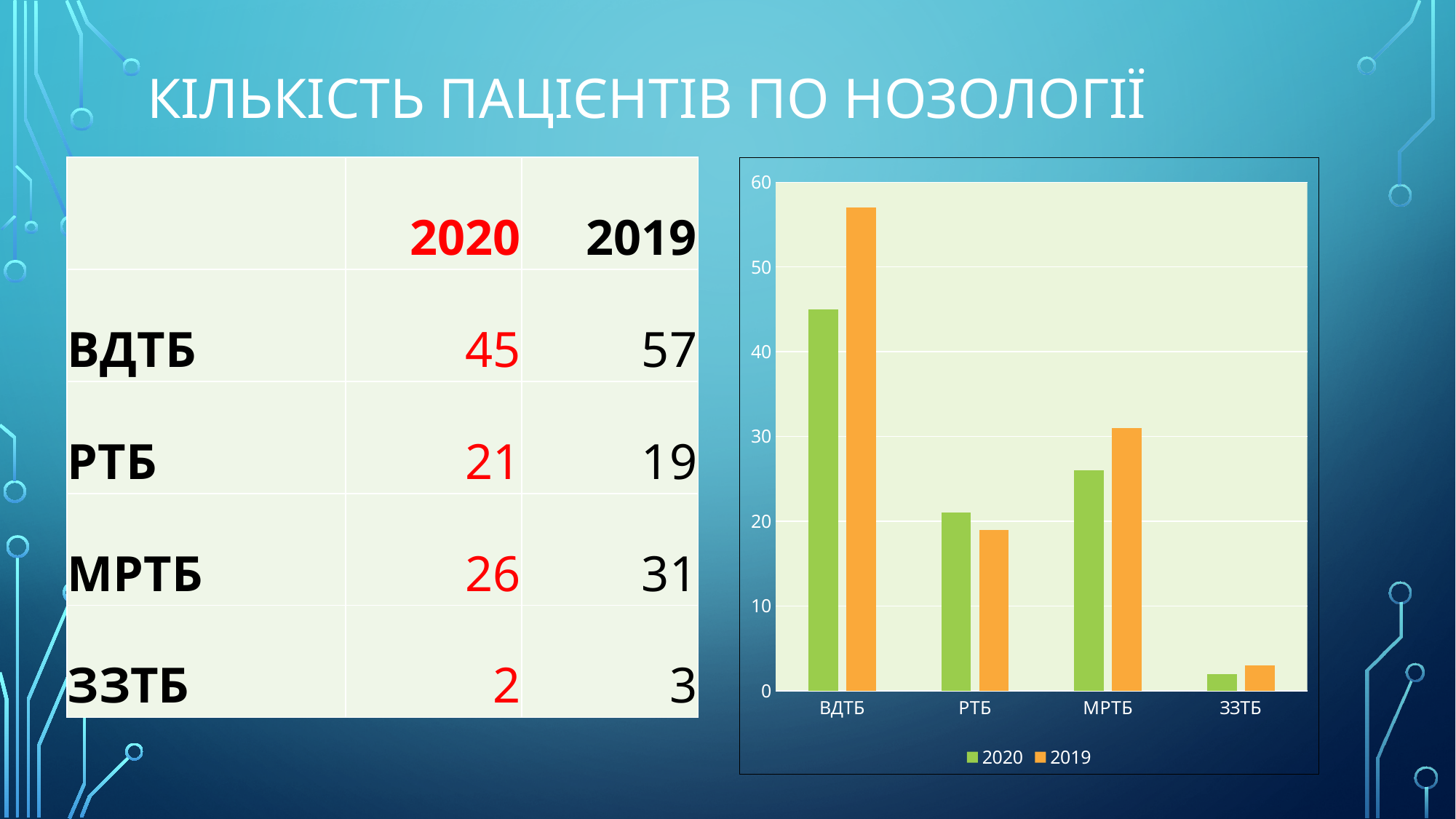
What is the value for МРТБ in 2020? 26 Which category has the highest value in the 2020 series? ВДТБ What is the value for ВДТБ in 2019? 57 What kind of chart is shown on the slide? bar chart How many series does the chart legend list? 2 How many categories are shown on the x axis of the chart? 4 What is the difference between the 2019 and 2020 values for ВДТБ? 12 Is the 2019 value for МРТБ greater or less than 20? greater Which colour represents the 2019 series in the chart? orange Which category has the lowest value in the 2019 series? ЗЗТБ What is the value for ЗЗТБ in 2019? 3 For РТБ, which year has the larger value, 2020 or 2019? 2020